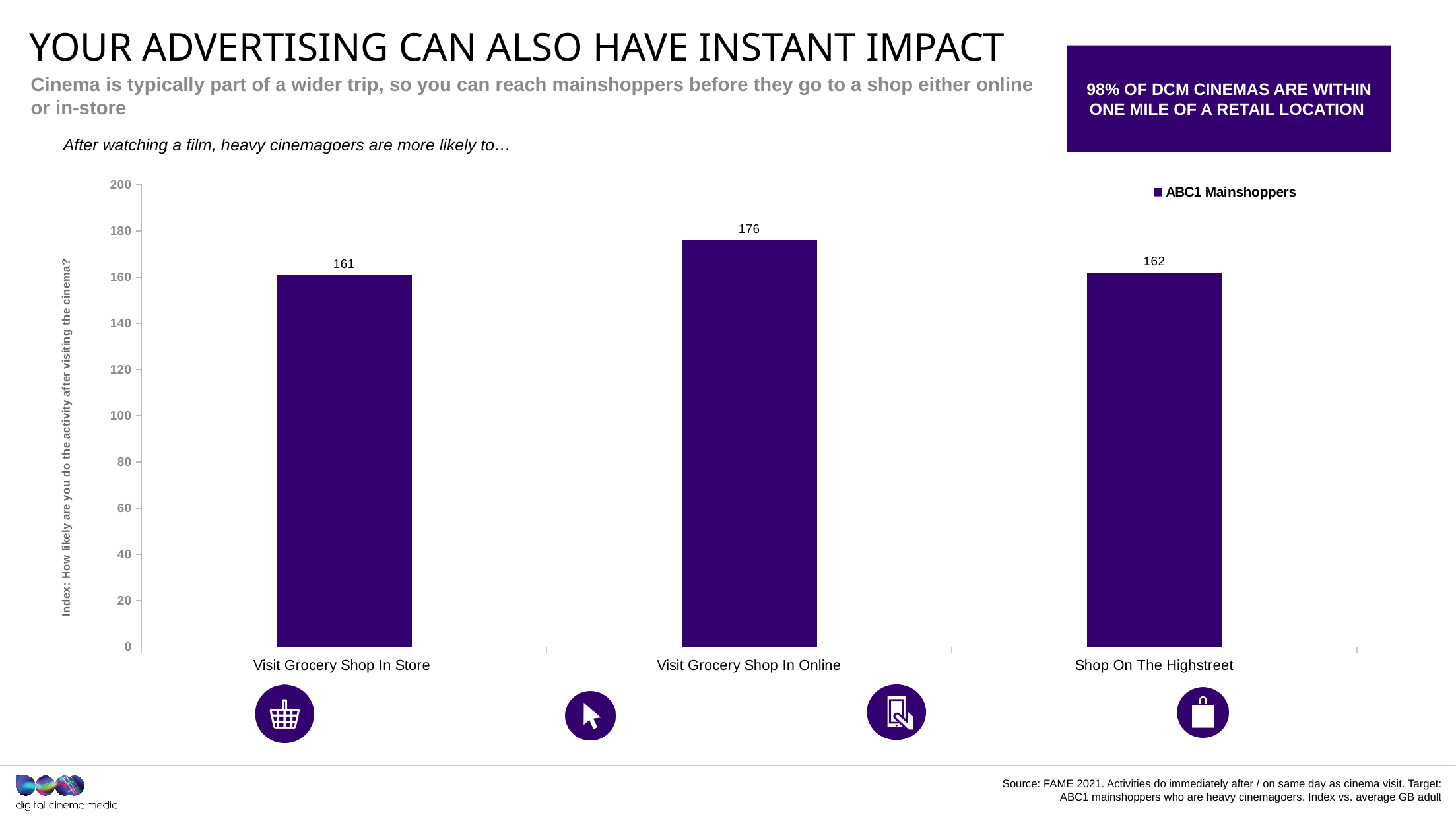
What is the index value for Visit Grocery Shop In Store? 161 What is the index value for Shop On The Highstreet? 162 What is the difference between the index values for Shop On The Highstreet and Visit Grocery Shop In Store? 1 How many series does the legend list? 1 Which is larger, the index for Visit Grocery Shop In Online or for Shop On The Highstreet? Visit Grocery Shop In Online Which activity has the highest index value? Visit Grocery Shop In Online What type of chart is shown on the slide? Bar chart Is the value for Visit Grocery Shop In Online greater or less than 160? greater Which activity has the lowest index value? Visit Grocery Shop In Store How many activity categories are shown on the chart? 3 What is the difference between the index values for Visit Grocery Shop In Online and Visit Grocery Shop In Store? 15 What is the index value for Visit Grocery Shop In Online? 176